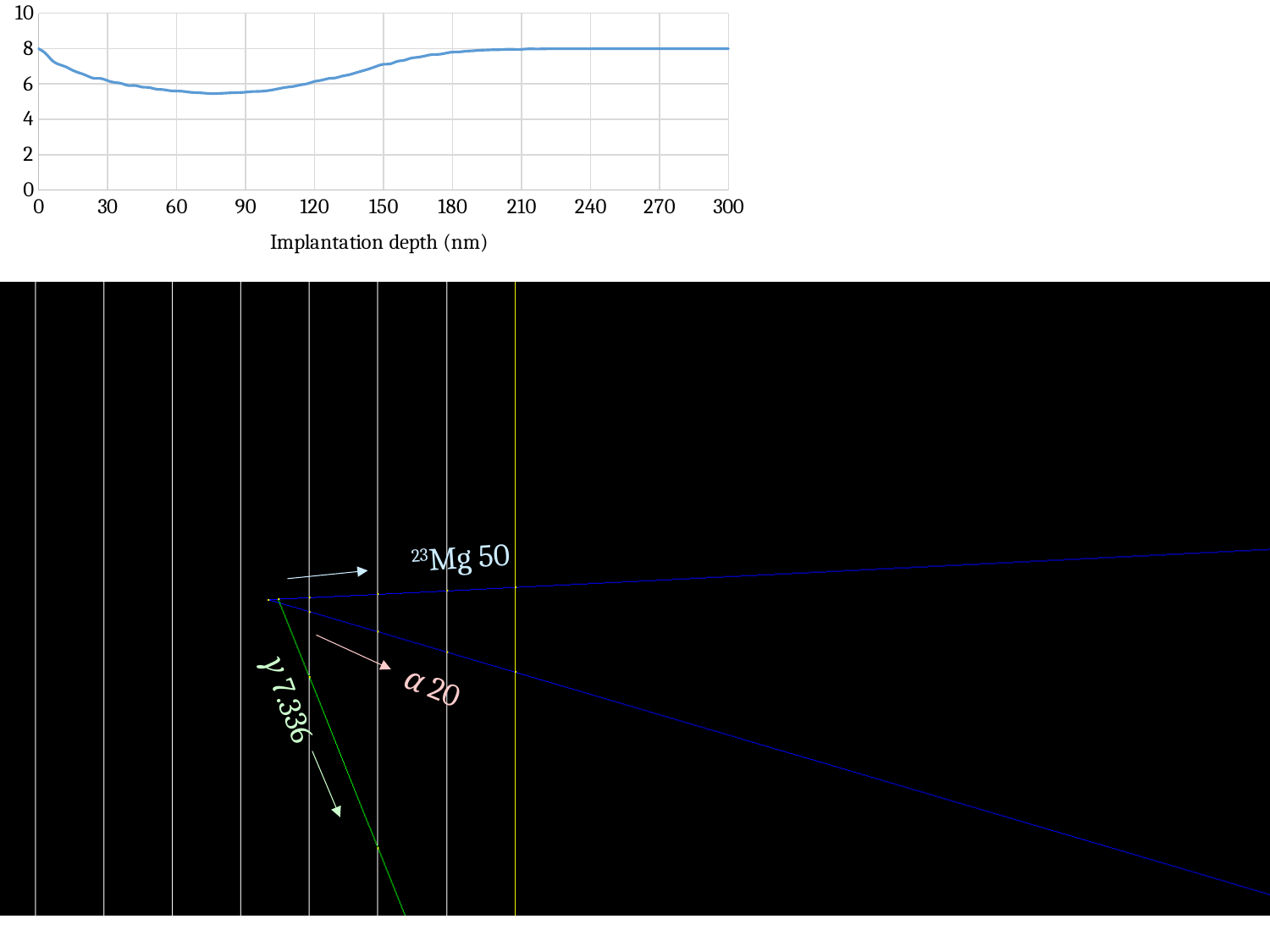
In the top chart, is the value at an implantation depth of 90 nm greater or less than 6? less In the top chart, is the value at an implantation depth of 300 nm greater or less than 6? greater In the top chart, is the value at an implantation depth of 0 nm greater or less than 6? greater What is the largest value labelled on the y axis of the top chart? 10 What is the title of the x axis of the top chart? Implantation depth (nm) In the top chart, which is larger: the value at 60 nm or the value at 180 nm? 180 nm In the top chart, does the line rise or fall between implantation depths of 0 nm and 90 nm? fall In the top chart, which is larger: the value at 0 nm or the value at 90 nm? 0 nm In the top chart, does the line rise or fall between implantation depths of 90 nm and 210 nm? rise What kind of chart is shown at the top of the slide? line chart